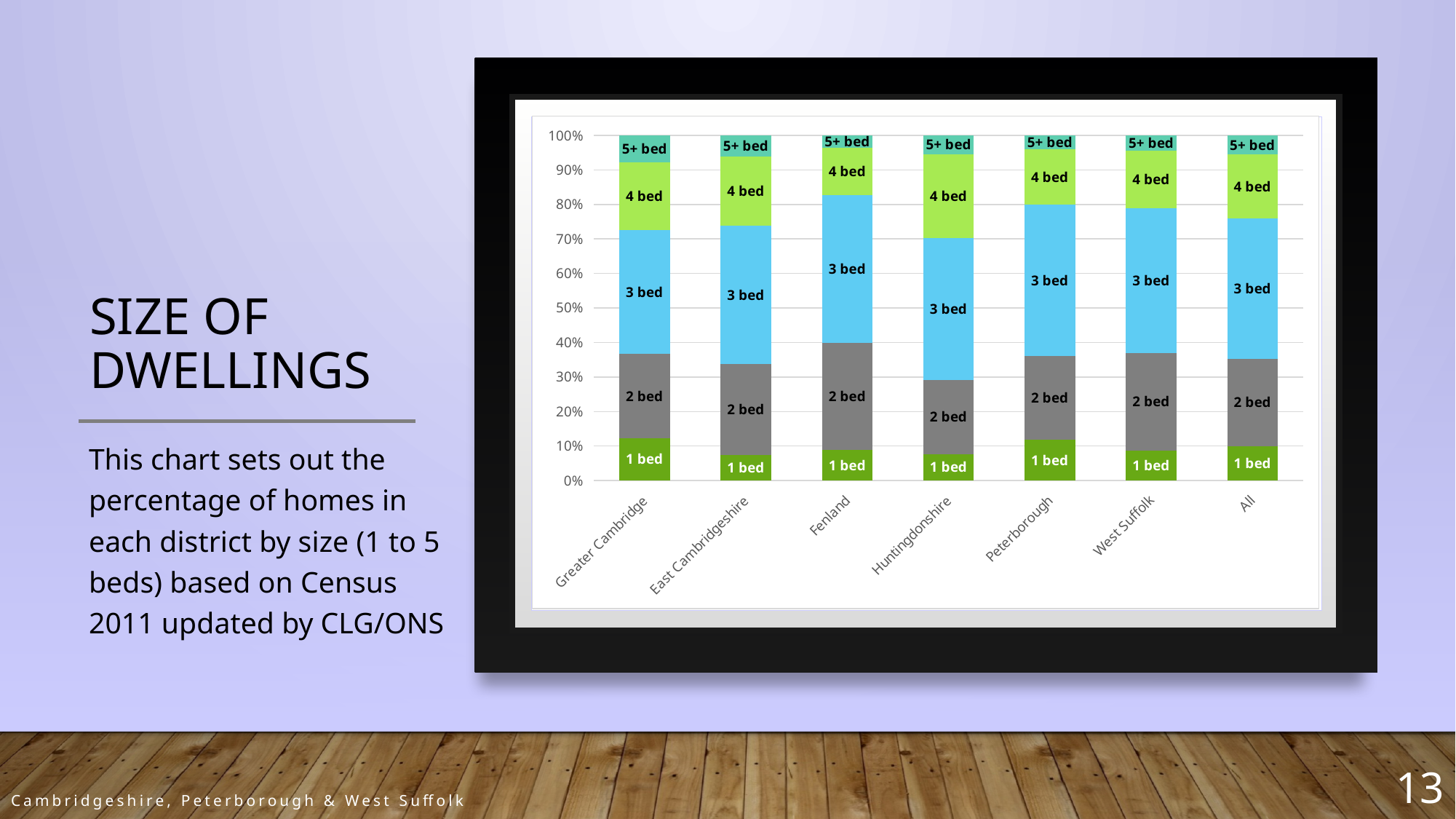
Which has the larger 3 bed segment, Greater Cambridge or Fenland? Fenland Which district has the largest 4 bed segment? Huntingdonshire What kind of chart is shown on the slide? Stacked bar chart Is the 1 bed share for Greater Cambridge greater or less than 10%? greater How many districts (categories) are shown along the x axis of the chart? 7 Is the 1 bed share for East Cambridgeshire greater or less than 10%? less Is the top of the 3 bed segment for Fenland greater or less than 80%? greater Which dwelling size segment sits at the bottom of every bar? 1 bed Which district has the smallest 4 bed segment? Fenland Which has the larger 2 bed segment, Huntingdonshire or Fenland? Fenland How many dwelling-size segments make up each bar in the chart? 5